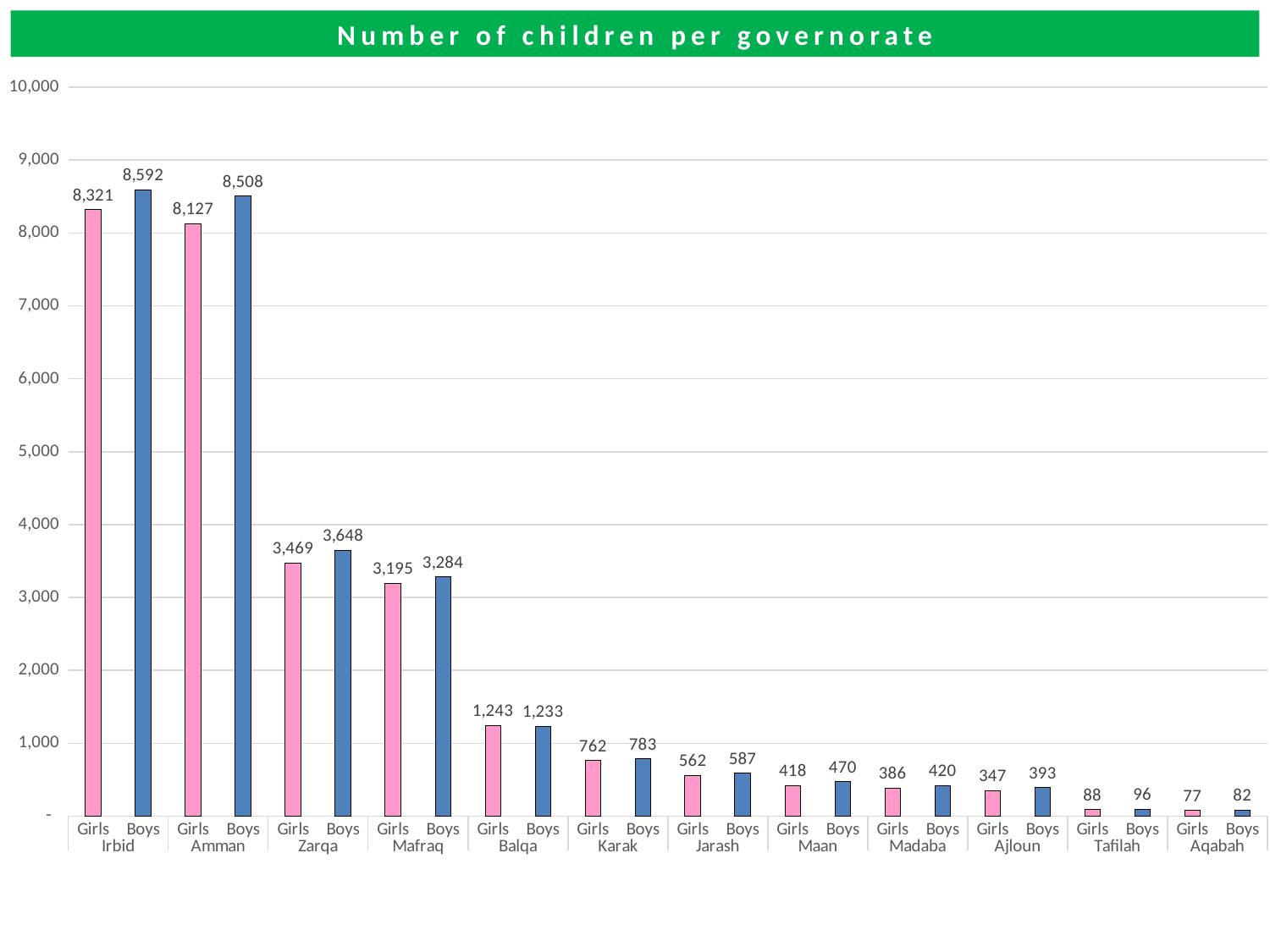
Is the number of boys in Karak greater or less than 1,000? less Which bar has the lowest value on the chart? Girls, Aqabah What is the difference between the number of boys and girls in Mafraq? 89 What is the number of girls in Balqa? 1,243 What is the number of boys in Amman? 8,508 How many governorates are shown on the chart? 12 What is the number of girls in Irbid? 8,321 Which is larger, the number of girls in Balqa or the number of boys in Balqa? Girls in Balqa What kind of chart is shown on the slide? Bar chart What is the title of the chart? Number of children per governorate Which bar has the highest value on the chart? Boys, Irbid What is the number of boys in Zarqa? 3,648